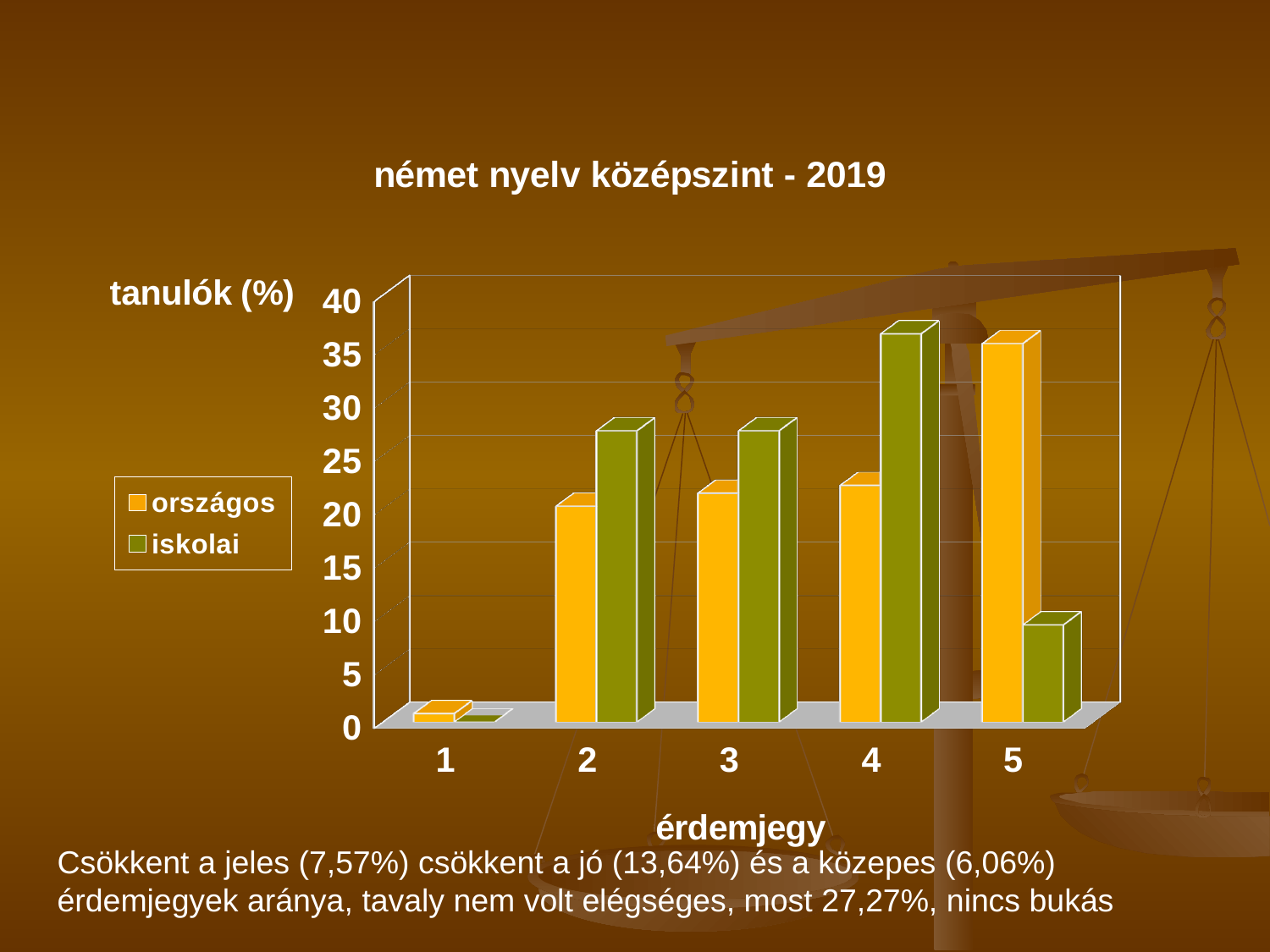
How many series does the legend list? 2 Is the országos value for érdemjegy 2 greater or less than 25? less Is the országos value for érdemjegy 5 greater or less than 30? greater For érdemjegy 4, which series has the larger value, országos or iskolai? iskolai What is the title of the chart? német nyelv középszint - 2019 How many érdemjegy categories are shown on the x axis? 5 For érdemjegy 5, which series has the larger value, országos or iskolai? országos Is the iskolai value for érdemjegy 4 greater or less than 30? greater What kind of chart is shown on the slide? bar chart What are the two series named in the legend? országos, iskolai Which érdemjegy has the highest iskolai value? 4